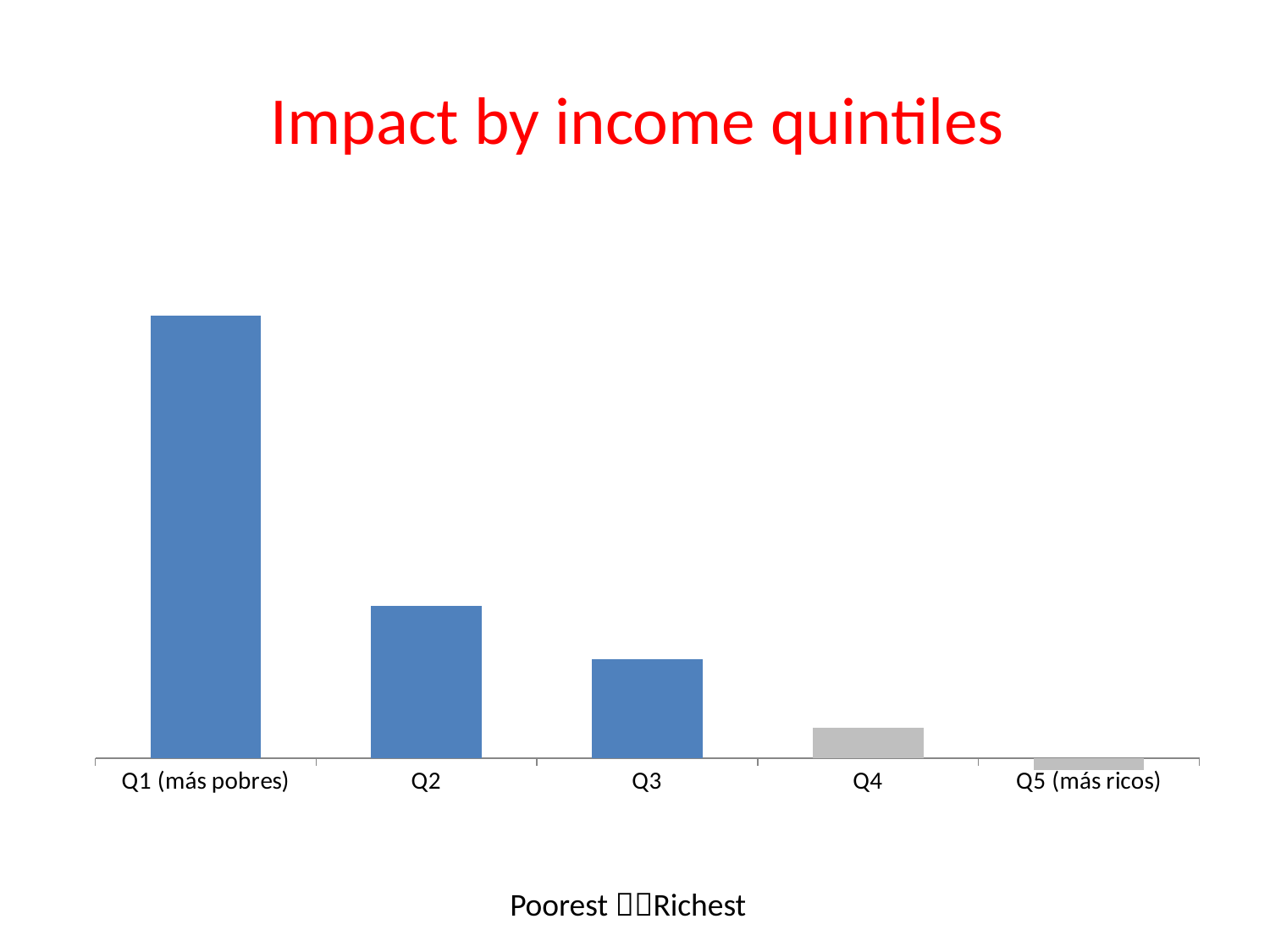
Which is larger, the value for Q3 or the value for Q4? Q3 What is the title of the chart on the slide? Impact by income quintiles Do the values rise or fall moving from Q1 (más pobres) to Q5 (más ricos) along the x axis? fall How many income quintiles are plotted on the chart? 5 Which quintile has the highest value on the chart? Q1 (más pobres) What kind of chart is shown on the slide? bar chart Which quintile's bar extends below the horizontal axis? Q5 (más ricos) Which is larger, the value for Q2 or the value for Q3? Q2 Which quintile has the lowest value on the chart? Q5 (más ricos) Which is larger, the value for Q1 (más pobres) or the value for Q2? Q1 (más pobres)